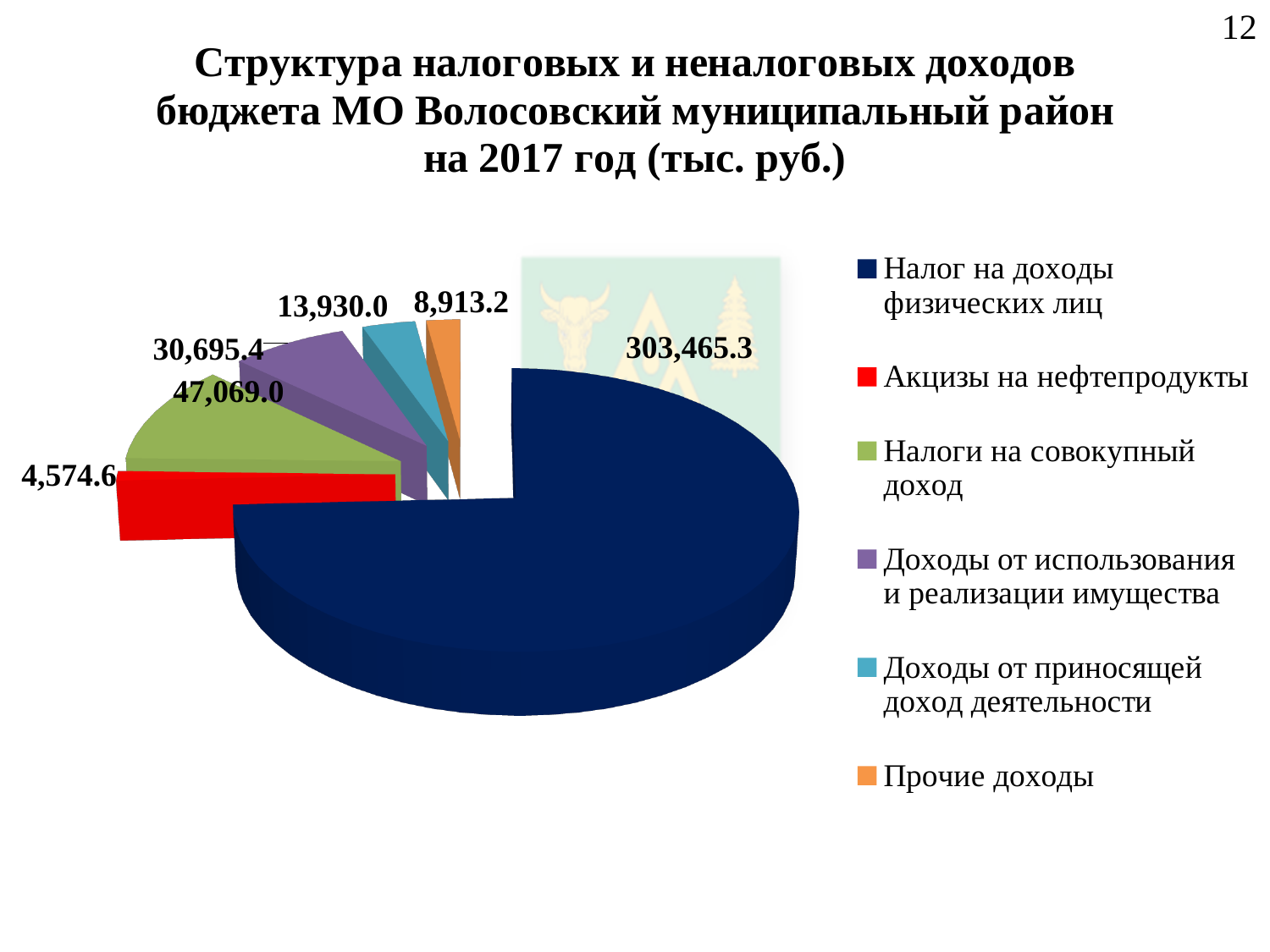
What is the value for Акцизы на нефтепродукты? 4,574.6 What is the value for Прочие доходы? 8,913.2 What kind of chart is shown on the slide? Pie chart Which category has the largest slice of the pie? Налог на доходы физических лиц What is the value for Налоги на совокупный доход? 47,069.0 What is the value for Налог на доходы физических лиц? 303,465.3 How many categories does the legend list? 6 Which category has the smallest slice of the pie? Акцизы на нефтепродукты What is the difference between Налоги на совокупный доход and Доходы от использования и реализации имущества? 16,373.6 What colour is the slice for Акцизы на нефтепродукты? Red Which is larger: Доходы от приносящей доход деятельности or Прочие доходы? Доходы от приносящей доход деятельности What is the value for Доходы от использования и реализации имущества? 30,695.4